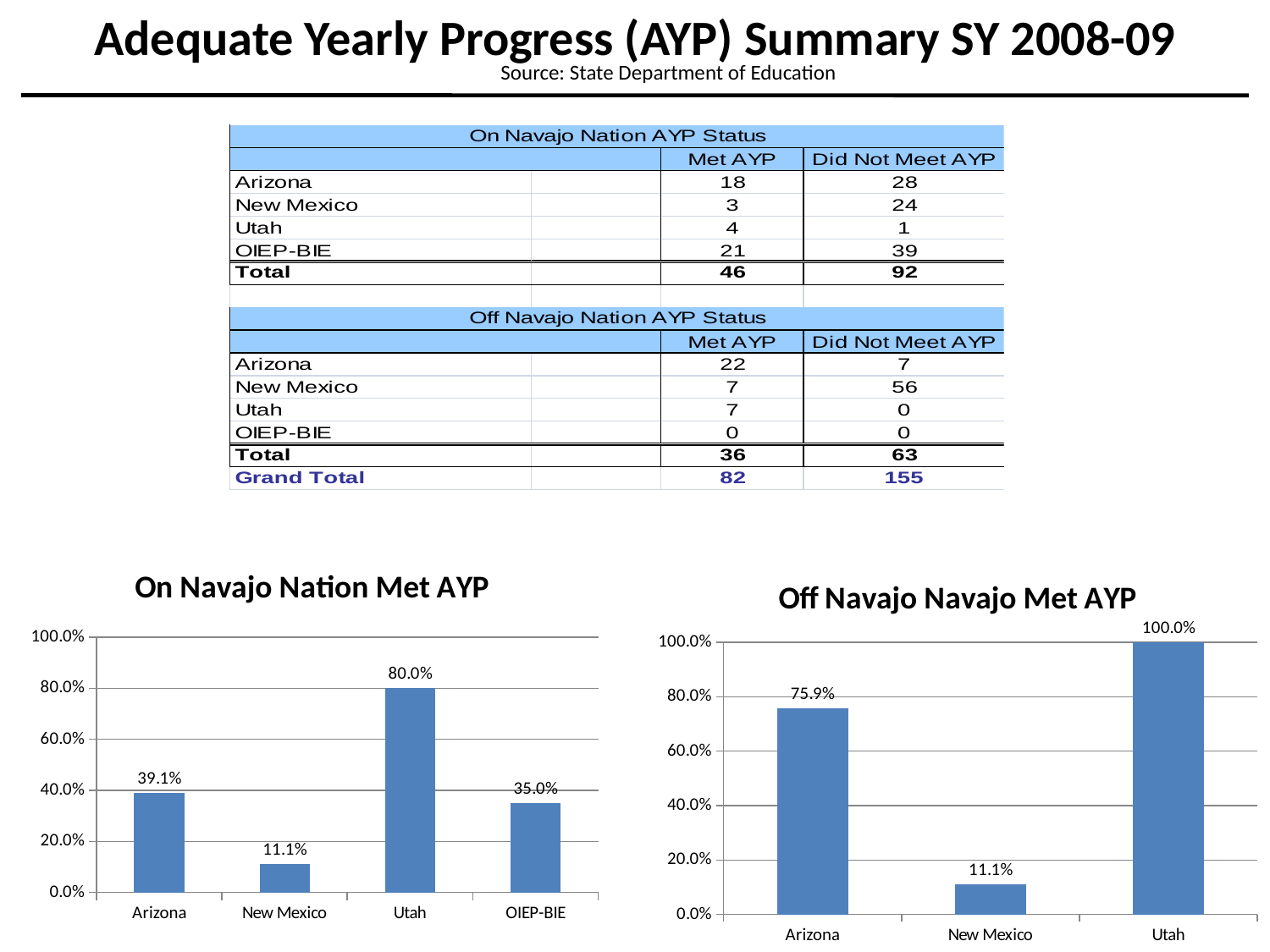
In the 'On Navajo Nation Met AYP' chart, what is the difference between the values for Utah and Arizona? 40.9% In the 'On Navajo Nation Met AYP' chart, what is the value for OIEP-BIE? 35.0% In the 'On Navajo Nation Met AYP' chart, which category has the lowest value? New Mexico How many categories are shown in the 'On Navajo Nation Met AYP' chart? 4 In the 'On Navajo Nation Met AYP' chart, which is larger, the value for Arizona or the value for OIEP-BIE? Arizona In the 'Off Navajo Navajo Met AYP' chart, what is the value for Arizona? 75.9% How many categories are shown in the 'Off Navajo Navajo Met AYP' chart? 3 In the 'On Navajo Nation Met AYP' chart, which category has the highest value? Utah In the 'Off Navajo Navajo Met AYP' chart, which category has the lowest value? New Mexico In the 'On Navajo Nation Met AYP' chart, what is the value for Utah? 80.0% In the 'Off Navajo Navajo Met AYP' chart, what is the difference between the values for Utah and Arizona? 24.1% What kind of chart is the 'Off Navajo Navajo Met AYP' chart? Bar chart